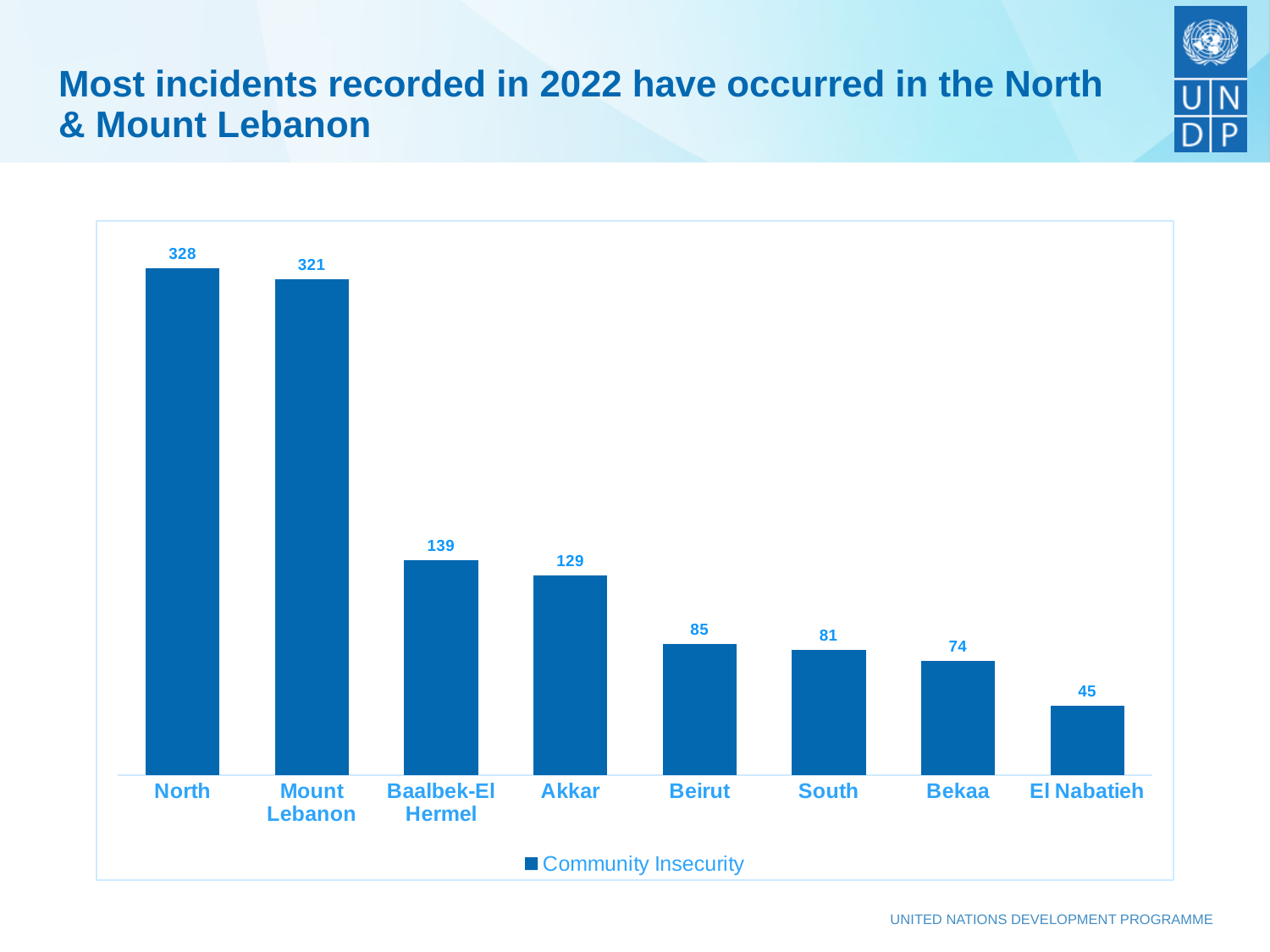
What is the name of the series in the legend? Community Insecurity Which category has the lowest value? El Nabatieh Which is larger, the value for Beirut or the value for Bekaa? Beirut What kind of chart is shown? Bar chart What is the difference between the values for Baalbek-El Hermel and Akkar? 10 What is the difference between the values for North and Mount Lebanon? 7 What is the value for Baalbek-El Hermel? 139 How many series does the legend list? 1 How many categories are shown on the x axis? 8 What is the value for El Nabatieh? 45 Which category has the highest value? North What is the value for North? 328